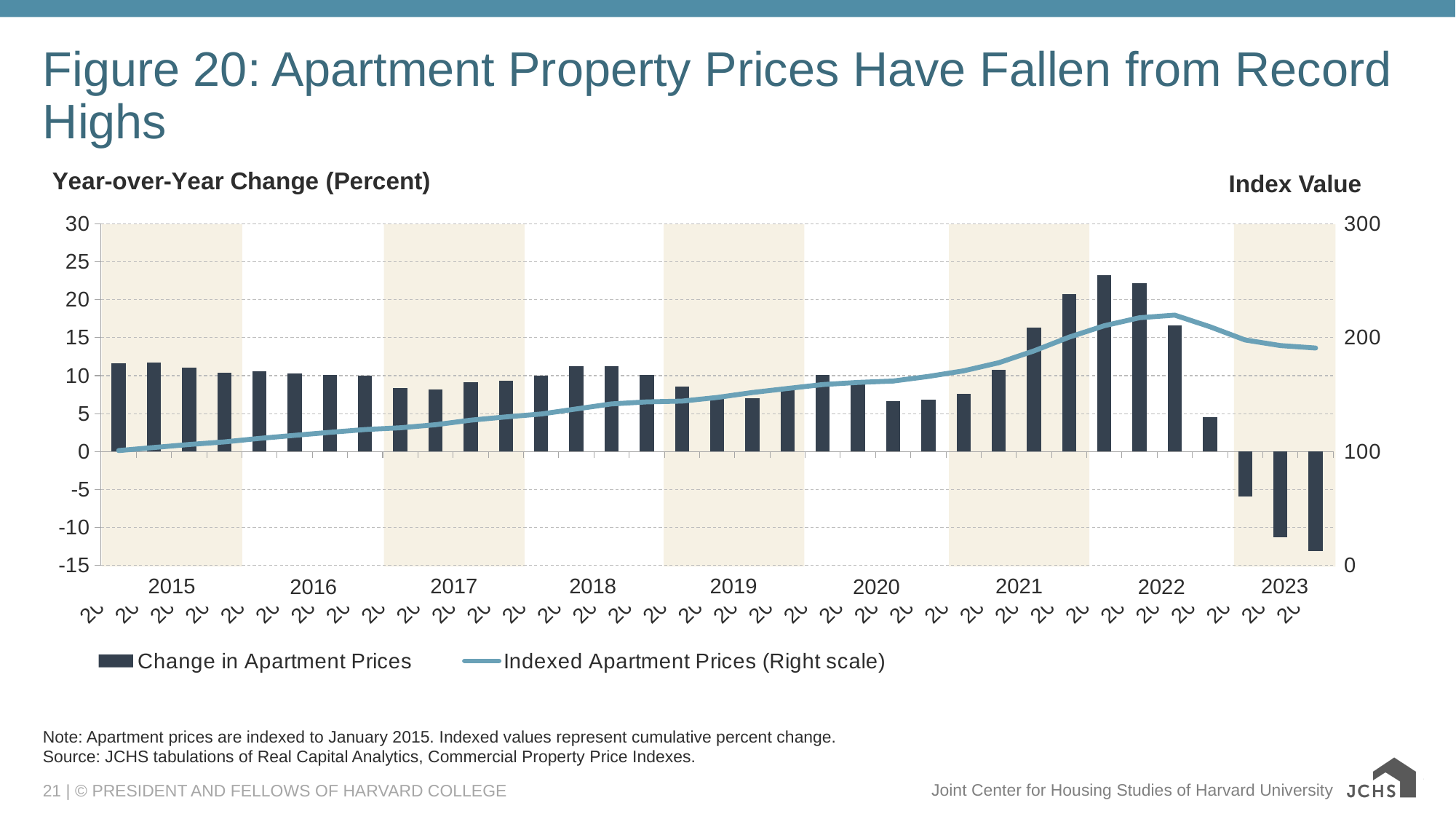
What are the two series named in the legend? Change in Apartment Prices; Indexed Apartment Prices (Right scale) In which year does the lowest bar for Change in Apartment Prices occur? 2023 In which year does the tallest bar for Change in Apartment Prices occur? 2022 Which is larger: the Change in Apartment Prices bar at the peak in 2021 or the first bar in 2015? The 2021 peak bar Is the final value of the Indexed Apartment Prices line in 2023 greater or less than 150 on the right scale? greater How many series does the legend list? 2 What kind of chart is shown on the slide? A combined bar and line chart What is the label of the left vertical axis? Year-over-Year Change (Percent) Is the last bar for Change in Apartment Prices in 2023 greater or less than -10? less Is the tallest bar for Change in Apartment Prices greater or less than 20? greater How does the Indexed Apartment Prices line move from 2015 to 2023? It rises steadily to a peak in 2022, then falls